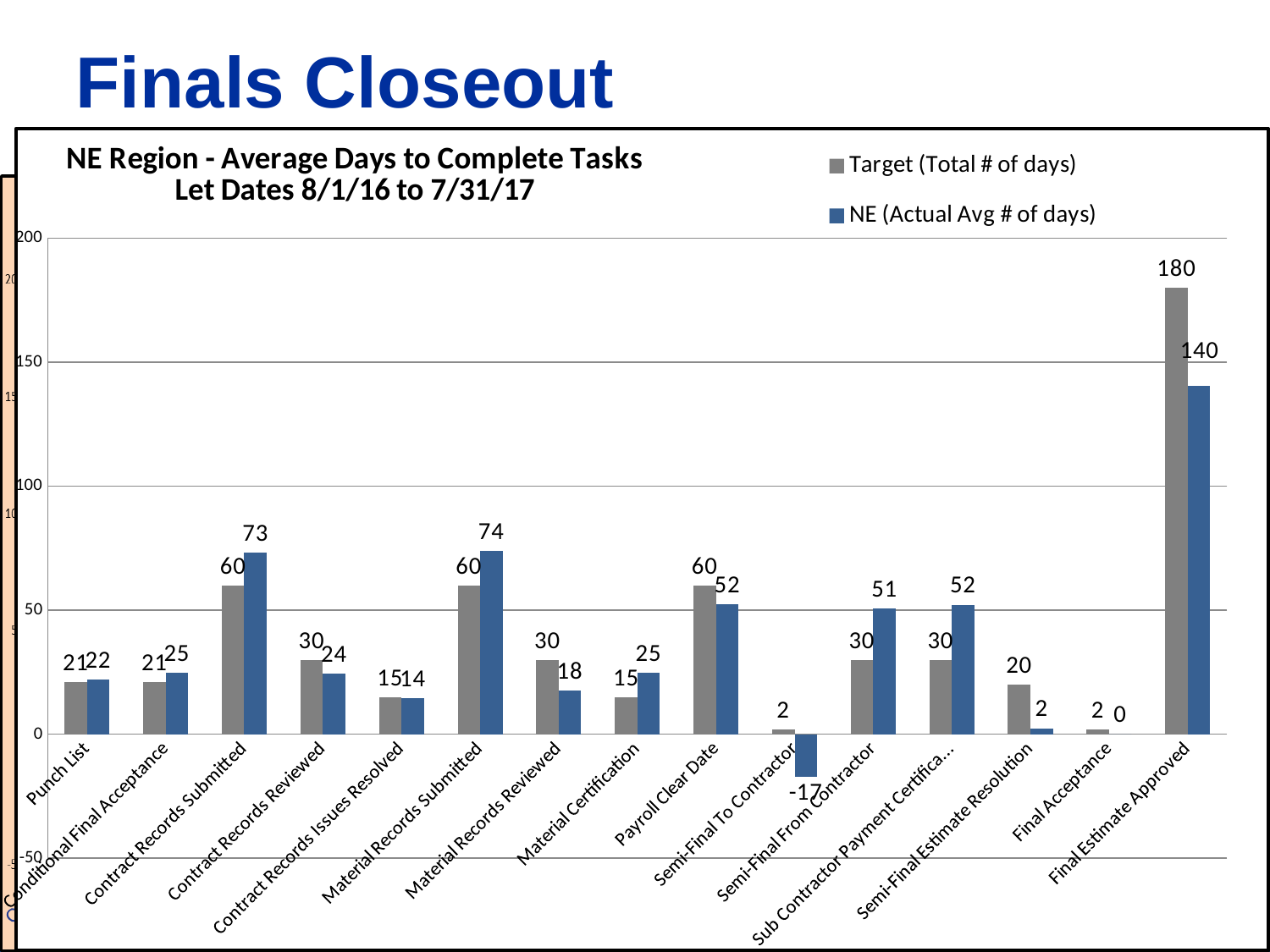
What is the difference between the Target and NE values for Final Estimate Approved? 40 How many series does the legend list? 2 What is the NE (Actual Avg # of days) value for Material Records Submitted? 74 What is the Target (Total # of days) value for Final Estimate Approved? 180 What kind of chart is shown on the slide? Bar chart What is the difference between the NE and Target values for Semi-Final From Contractor? 21 For Payroll Clear Date, which is larger: the Target value or the NE value? Target Which category has the highest NE (Actual Avg # of days) value? Final Estimate Approved How many task categories are shown on the x axis? 15 What is the Target (Total # of days) value for Contract Records Submitted? 60 What is the NE (Actual Avg # of days) value for Semi-Final To Contractor? -17 Which category has the lowest NE (Actual Avg # of days) value? Semi-Final To Contractor